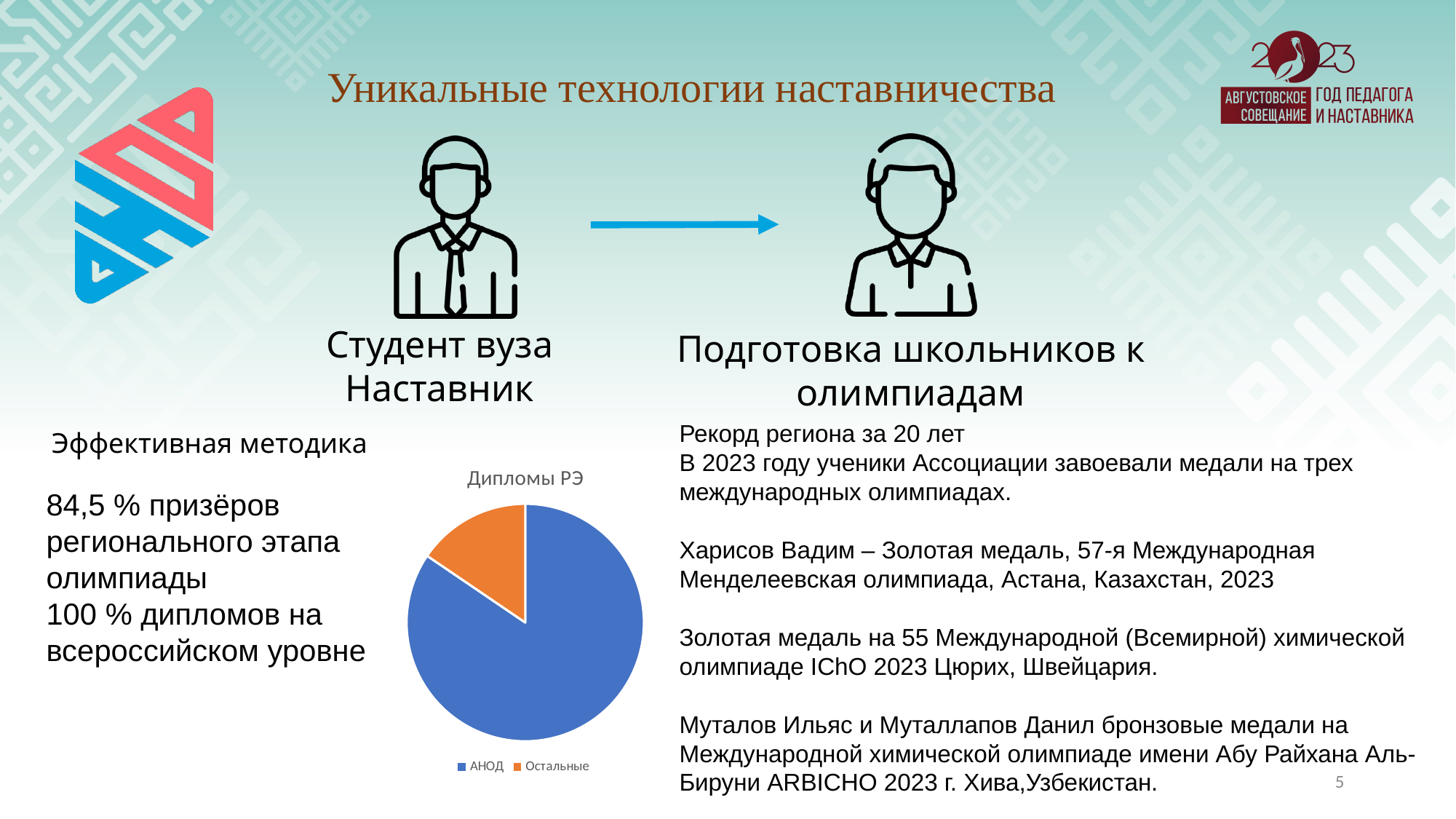
What is the title of the pie chart? Дипломы РЭ Which slice is larger in the pie chart, АНОД or Остальные? АНОД What colour is the АНОД slice in the pie chart? blue How many entries does the legend of the pie chart list? 2 How many slices does the pie chart have? 2 What kind of chart is shown on the slide? pie chart Which category has the smallest slice in the pie chart? Остальные Which category has the largest slice in the pie chart? АНОД Which category is shown in orange in the pie chart? Остальные